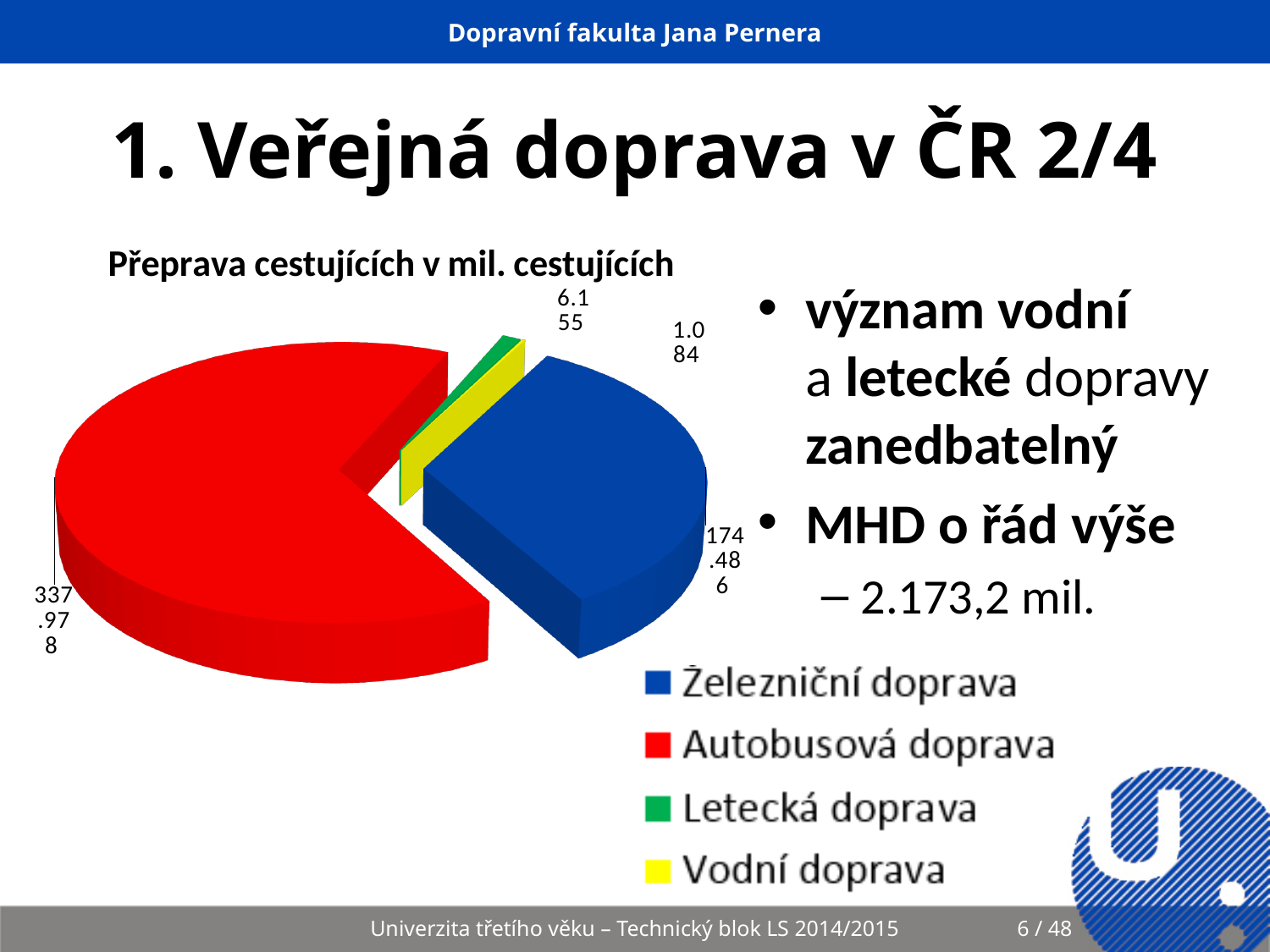
What is the value shown for Autobusová doprava? 337.978 What is the title of the chart? Přeprava cestujících v mil. cestujících Which colour represents Letecká doprava in the pie chart? green What type of chart is shown on the slide? pie chart What is the value shown for Vodní doprava? 1.084 Which is larger, Železniční doprava or Autobusová doprava? Autobusová doprava Which category has the smallest slice of the pie? Vodní doprava What is the value shown for Železniční doprava? 174.486 What is the difference between the values for Autobusová doprava and Železniční doprava? 163.492 Which category has the largest slice of the pie? Autobusová doprava How many categories does the legend of the pie chart list? 4 What is the value shown for Letecká doprava? 6.155